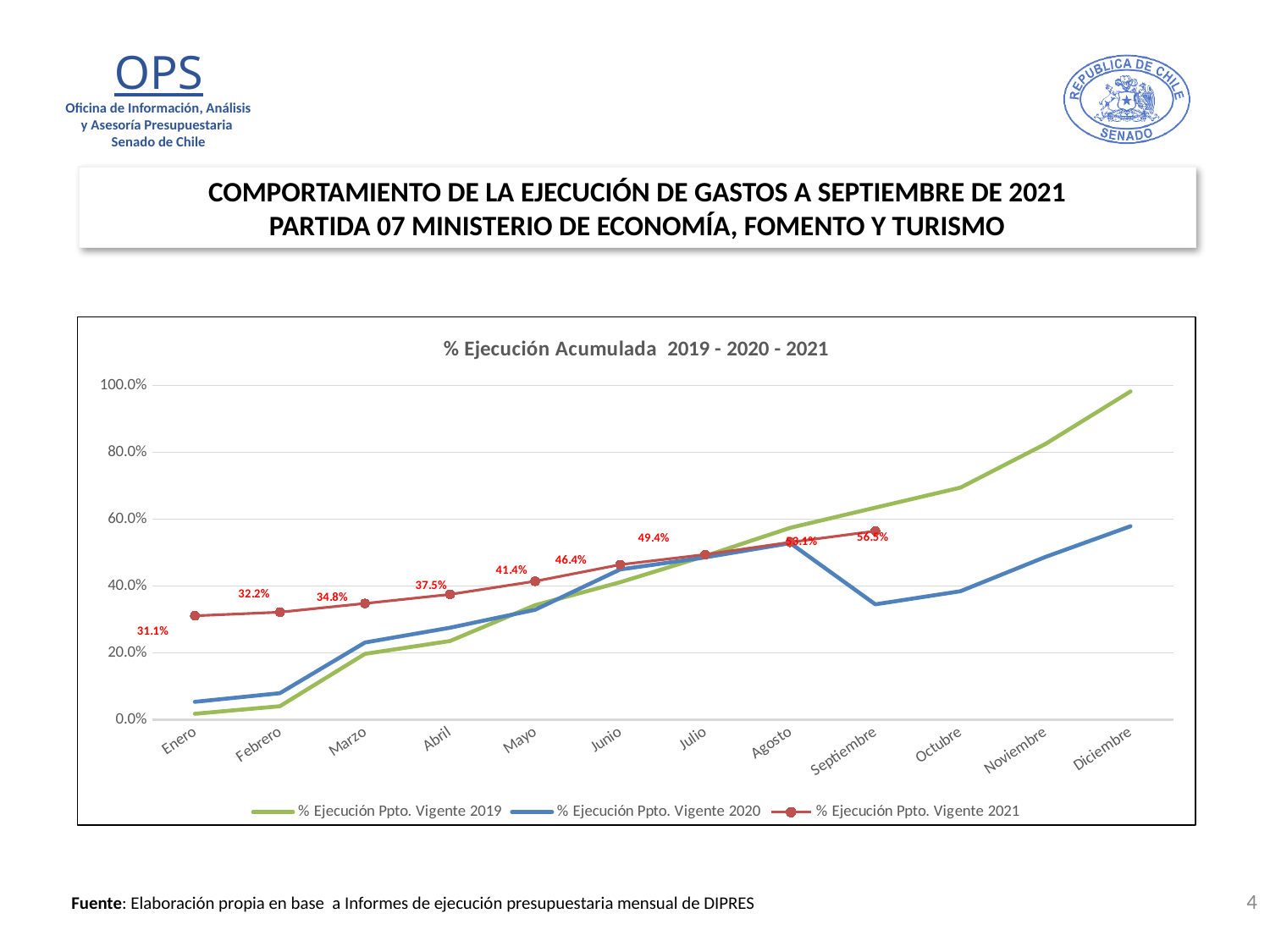
Is the value of % Ejecución Ppto. Vigente 2020 for Septiembre greater or less than 40.0%? less What is the title of the chart? % Ejecución Acumulada 2019 - 2020 - 2021 Does the % Ejecución Ppto. Vigente 2021 series rise or fall from Enero to Julio? rise What is the value of % Ejecución Ppto. Vigente 2021 for Enero? 31.1% How many series does the legend list? 3 What is the difference between the % Ejecución Ppto. Vigente 2021 values for Junio and Mayo? 5.0% What type of chart is shown on the slide? line chart What is the value of % Ejecución Ppto. Vigente 2021 for Julio? 49.4% How many months are shown on the x axis? 12 In Enero, which series has the higher value: % Ejecución Ppto. Vigente 2020 or % Ejecución Ppto. Vigente 2021? % Ejecución Ppto. Vigente 2021 What is the value of % Ejecución Ppto. Vigente 2021 for Abril? 37.5% Is the value of % Ejecución Ppto. Vigente 2019 for Diciembre greater or less than 80.0%? greater